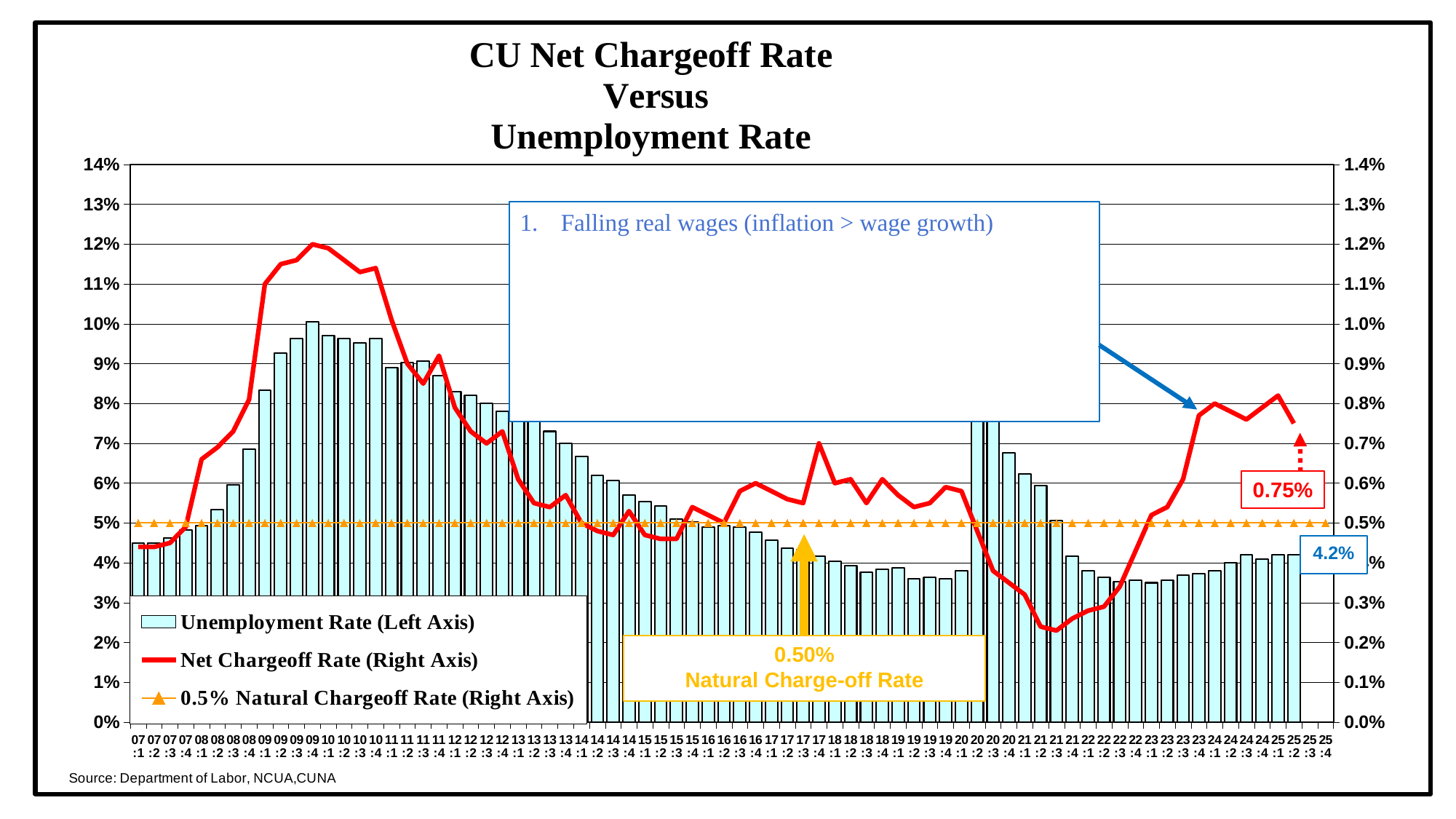
What value is labelled in red for the projected Net Chargeoff Rate? 0.75% What is the title of the chart? CU Net Chargeoff Rate Versus Unemployment Rate Is the Net Chargeoff Rate for 09:4 greater or less than 1.1%? greater What is the highest value shown on the right axis? 1.4% What kind of chart is this? Combination bar and line chart What is the labelled value of the most recent Unemployment Rate bar? 4.2% How many series does the legend list? 3 Which is larger, the Net Chargeoff Rate at 09:4 or at 25:1? 09:4 Is the Unemployment Rate for 09:2 greater or less than 9%? greater Does the Net Chargeoff Rate rise or fall from 21:3 to 24:1? rise Is the Net Chargeoff Rate for 21:3 greater or less than 0.3%? less What value is labelled for the Natural Charge-off Rate? 0.50%